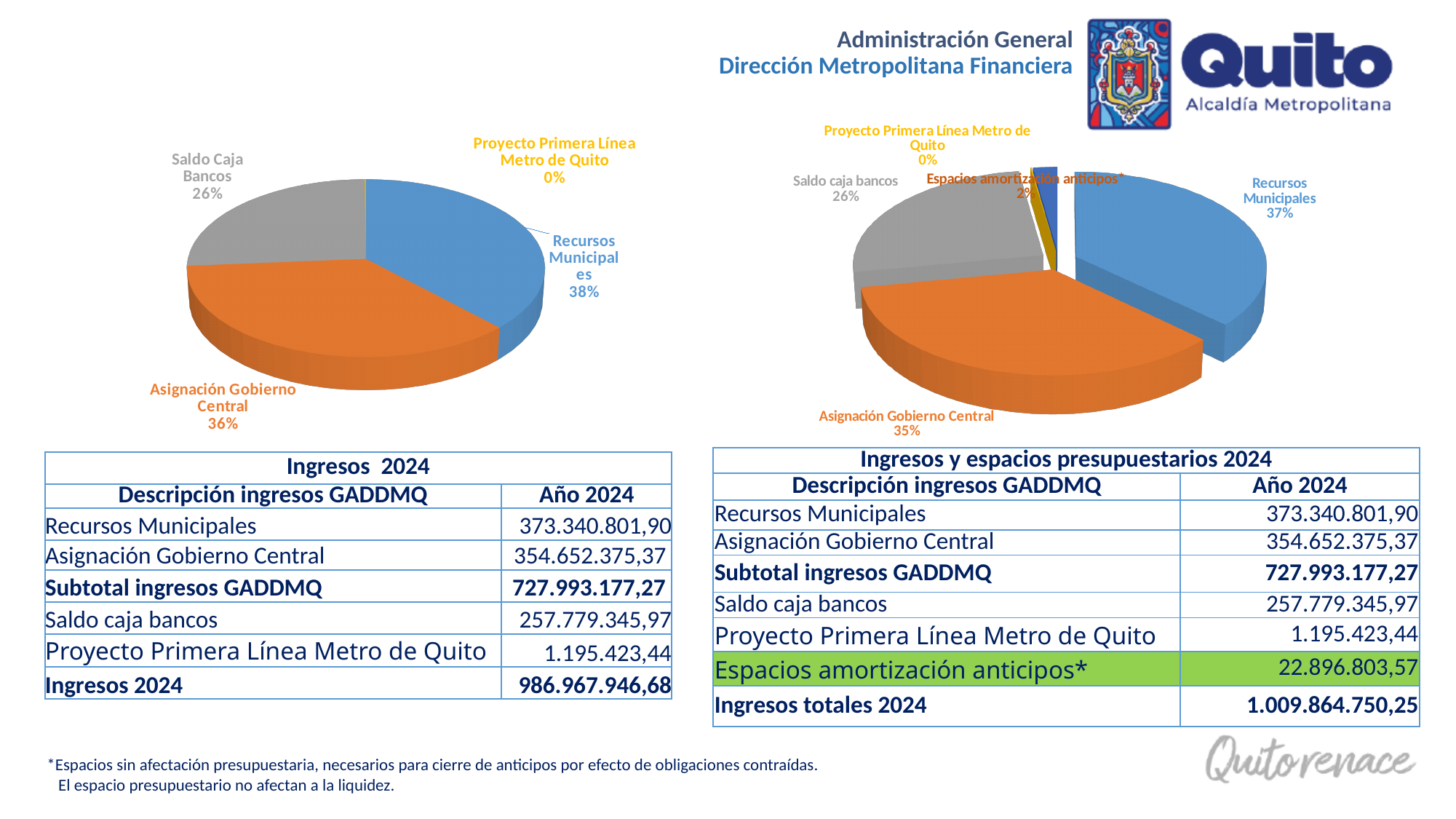
In the left pie chart, what share does Asignación Gobierno Central have? 36% How many slices does the left pie chart have? 4 In the right pie chart, what share does Espacios amortización anticipos* have? 2% What type of chart is the right chart? Pie chart In the left pie chart, which slice is the largest? Recursos Municipales In the right pie chart, what share does Recursos Municipales have? 37% In the left pie chart, which slice is the smallest? Proyecto Primera Línea Metro de Quito How many slices does the right pie chart have? 5 In the right pie chart, what is the difference in percentage points between Recursos Municipales and Saldo caja bancos? 11